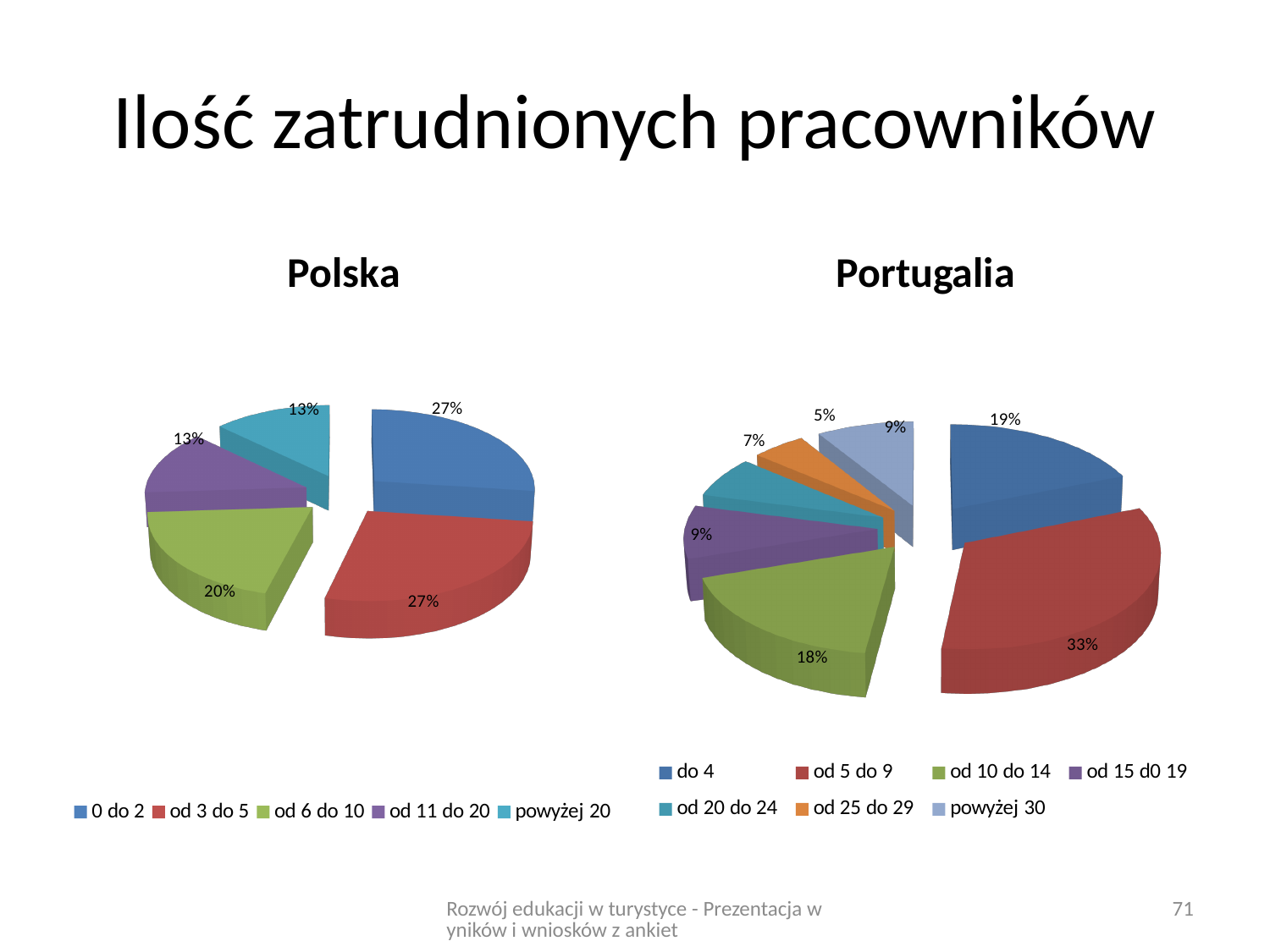
In the Polska chart, what share does the 'od 6 do 10' slice have? 20% In the Portugalia chart, what is the difference between the 'od 5 do 9' share and the 'do 4' share? 14% In the Portugalia chart, which is larger: 'od 20 do 24' or 'od 25 do 29'? od 20 do 24 What type of charts are shown on the slide? pie charts In the Polska chart, what share does the '0 do 2' slice have? 27% In the Portugalia chart, which category has the largest share? od 5 do 9 In the Portugalia chart, what share does the 'od 10 do 14' slice have? 18% How many categories does the legend of the Polska chart list? 5 In the Portugalia chart, which category has the smallest share? od 25 do 29 How many categories does the legend of the Portugalia chart list? 7